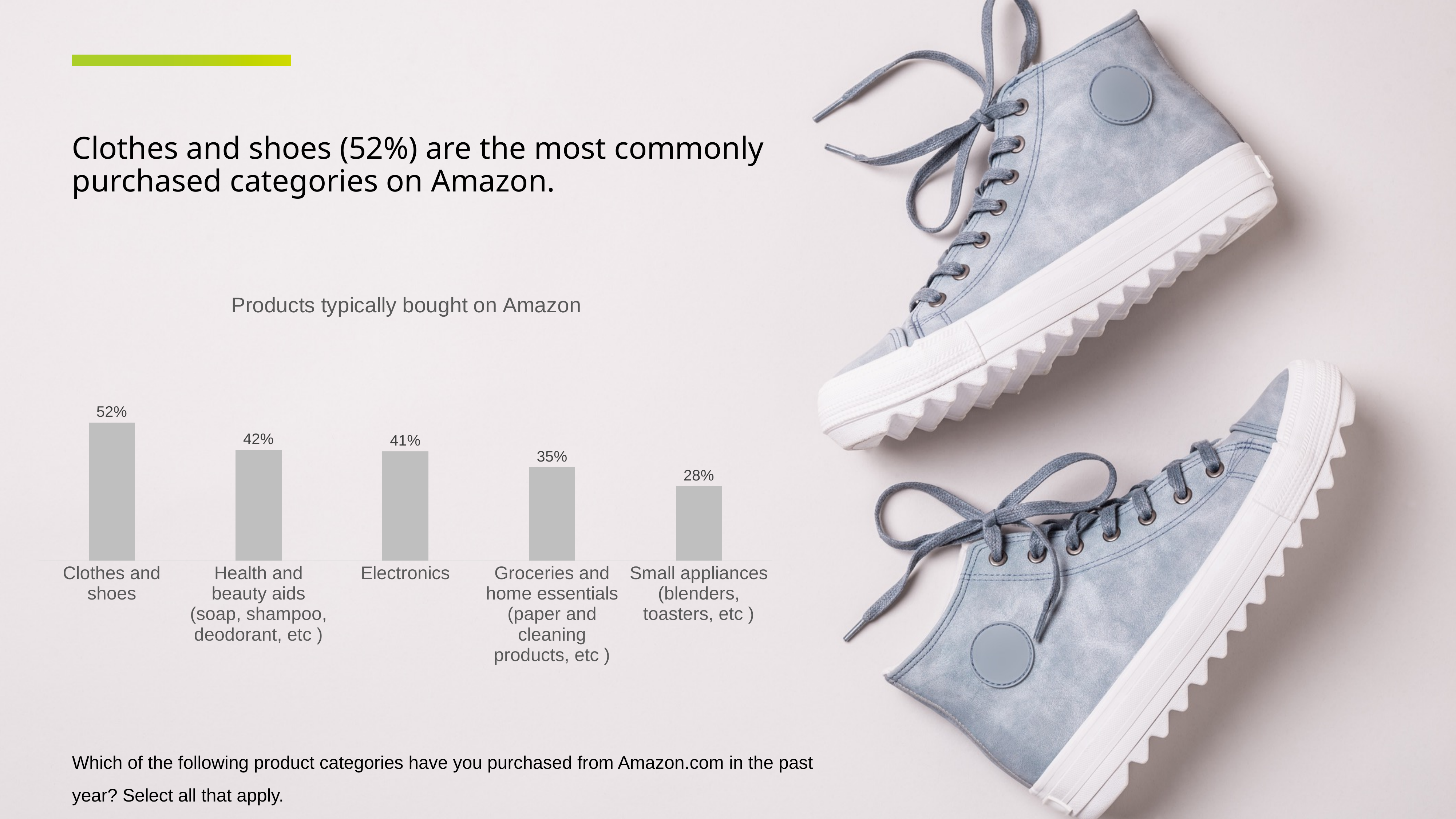
What percentage of respondents typically buy clothes and shoes on Amazon? 52% What is the difference between the values for Health and beauty aids and Groceries and home essentials? 7 percentage points Which product category has the lowest value in the chart? Small appliances (blenders, toasters, etc) What is the value shown for Electronics? 41% What is the title of the chart? Products typically bought on Amazon Which product category has the highest value in the chart? Clothes and shoes Which has a higher value, Electronics or Groceries and home essentials? Electronics What kind of chart is shown on the slide? Bar chart What is the value for Groceries and home essentials? 35% What is the difference between the values for Clothes and shoes and Small appliances? 24 percentage points What is the value for Small appliances (blenders, toasters, etc)? 28% How many product categories are shown in the chart? 5